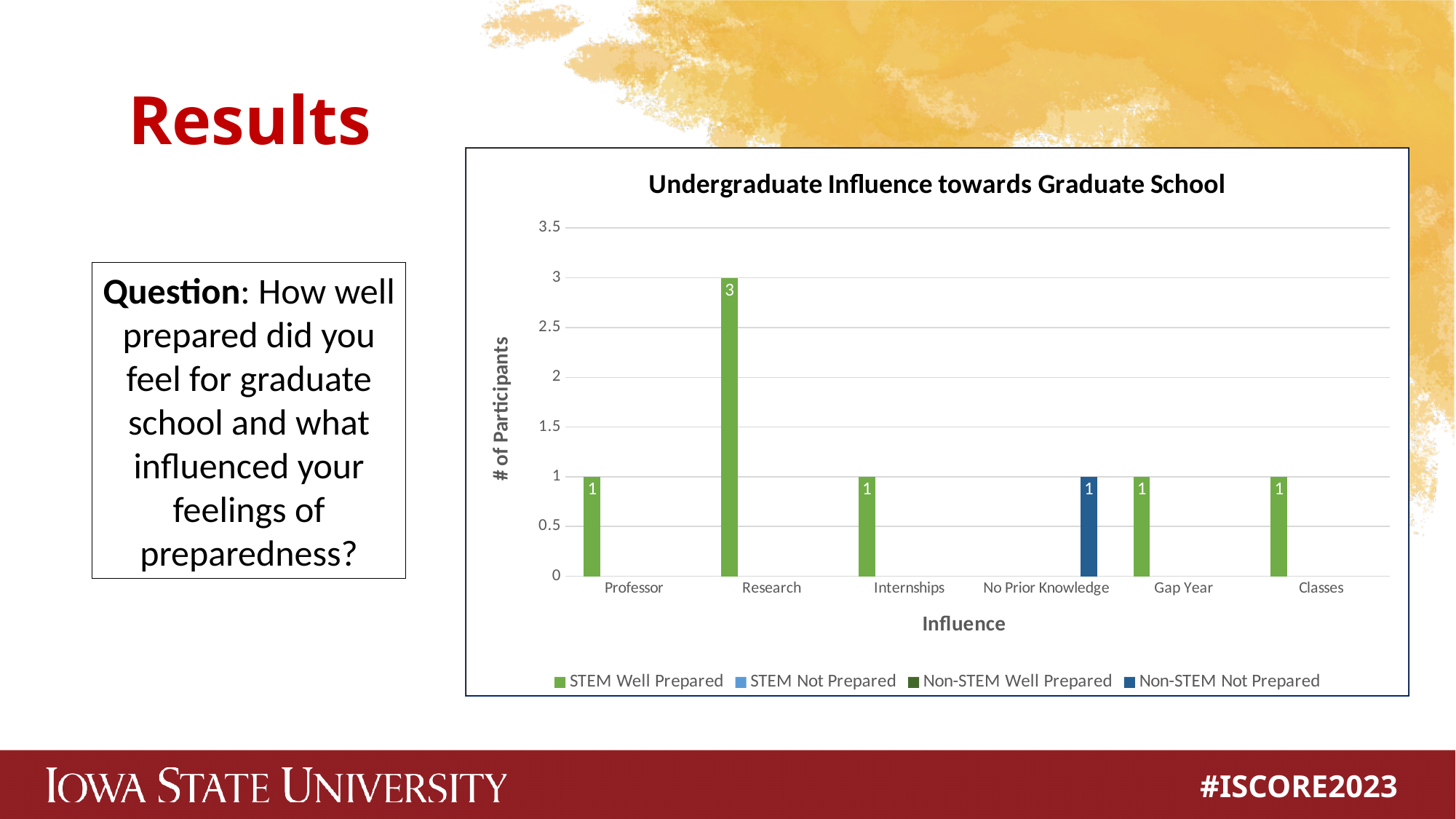
What kind of chart is shown on the slide? bar chart What is the value for STEM Well Prepared in the Professor category? 1 How many series does the chart legend list? 4 Which influence category has the highest number of participants? Research What is the title of the chart? Undergraduate Influence towards Graduate School What is the value for STEM Well Prepared in the Research category? 3 Which is larger, the STEM Well Prepared value for Research or for Gap Year? Research What is the difference between the STEM Well Prepared values for Research and Internships? 2 What is the value for Non-STEM Not Prepared in the No Prior Knowledge category? 1 Is the value for Research greater or less than 2? greater What is the label of the y axis? # of Participants How many influence categories are shown on the x axis? 6